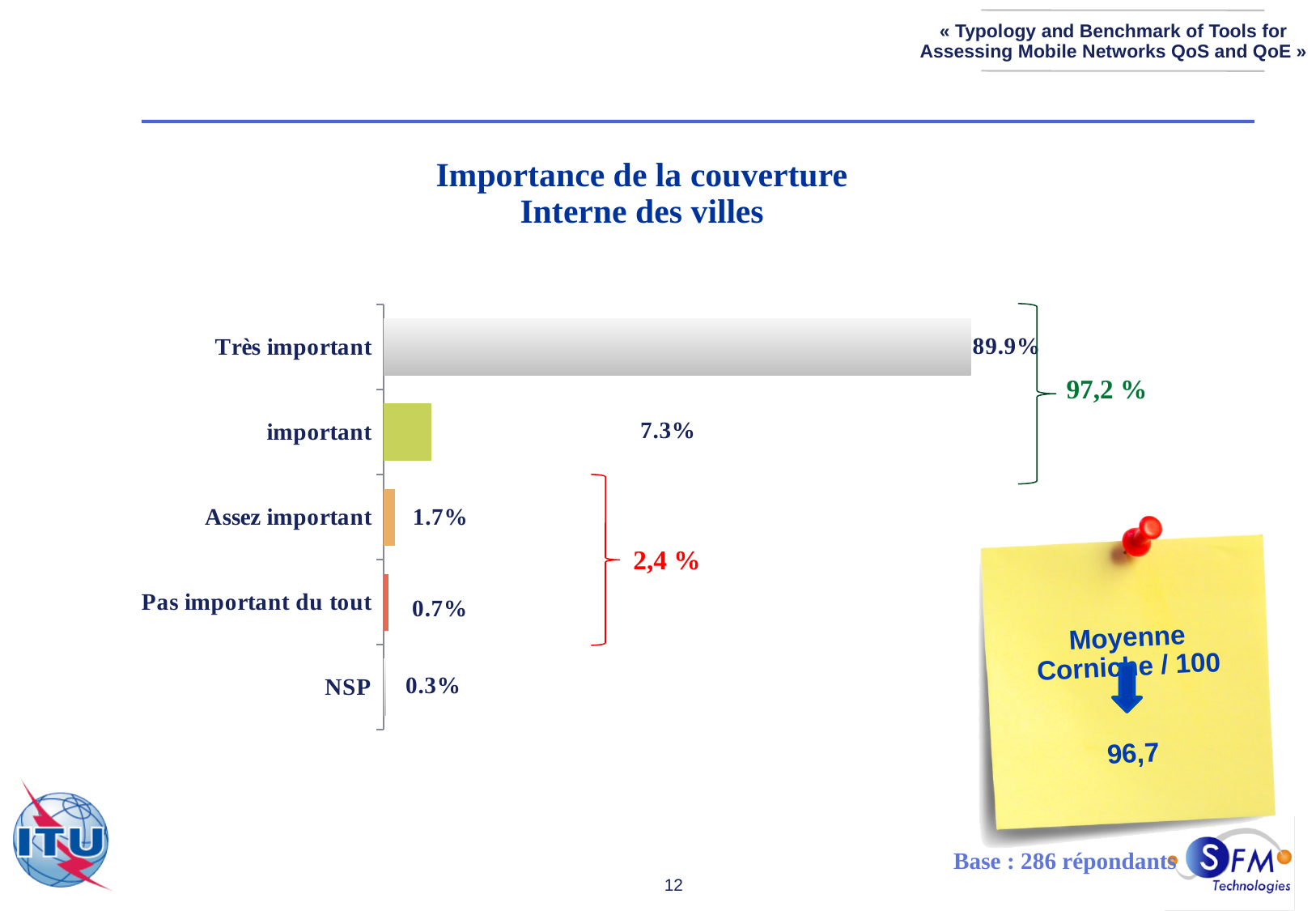
What kind of chart is shown on the slide? Bar chart What is the title of the chart? Importance de la couverture Interne des villes Which is larger, the value for "Assez important" or the value for "Pas important du tout"? Assez important What is the value for "important"? 7.3% What is the value for "Très important"? 89.9% Which category has the highest value? Très important How many categories are shown in the chart? 5 What is the difference between the values for "Très important" and "important"? 82.6% What is the value for "NSP"? 0.3% What is the value for "Pas important du tout"? 0.7% Which category has the lowest value? NSP What is the value for "Assez important"? 1.7%